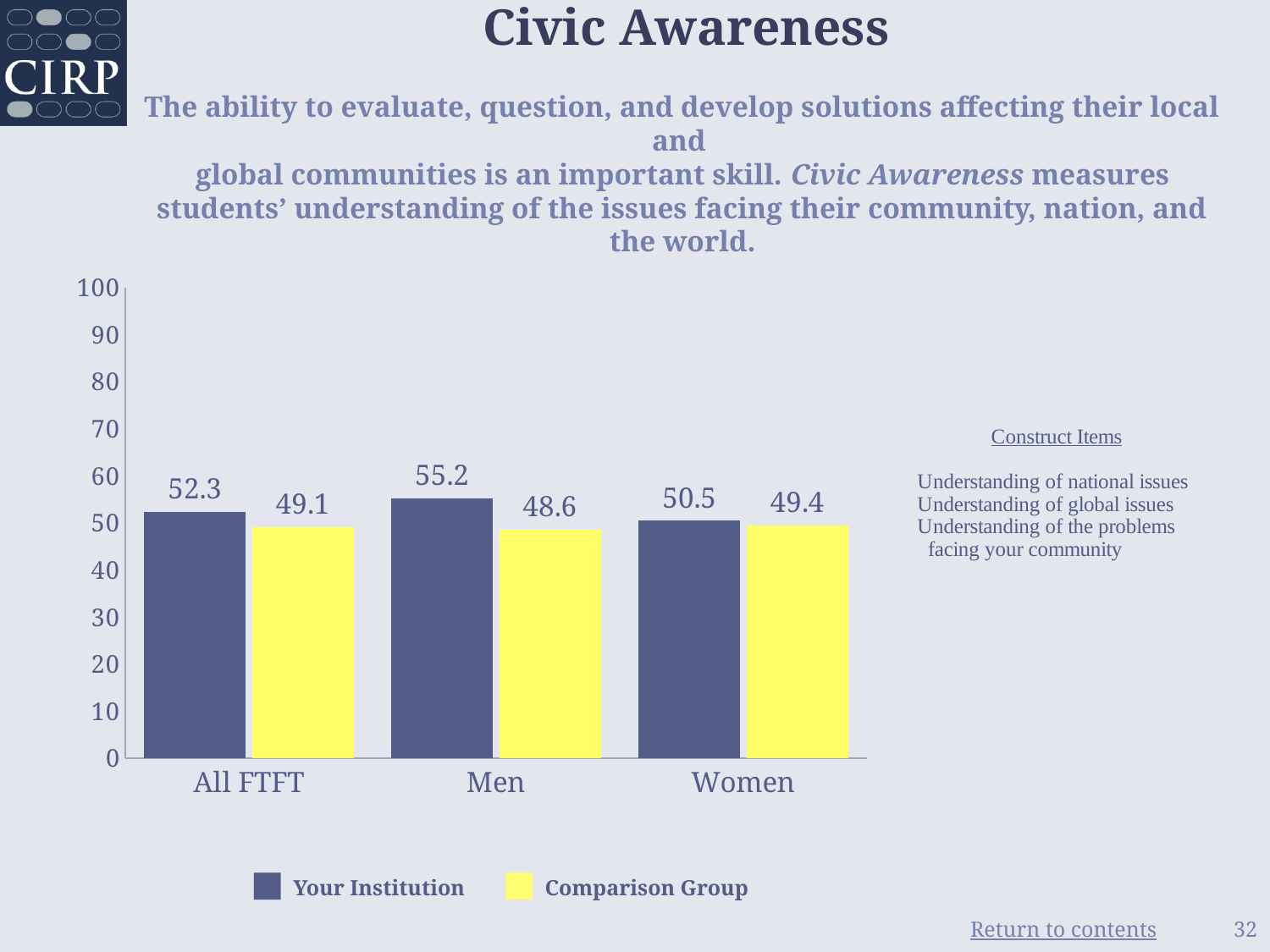
In the Women category, which is larger: Your Institution or Comparison Group? Your Institution Which category has the highest value for Your Institution? Men What is the difference between Your Institution and Comparison Group in the All FTFT category? 3.2 What is the value for Your Institution in the Women category? 50.5 How many series does the legend list? 2 What kind of chart is shown on the slide? bar chart Is the value for Comparison Group in the Men category greater or less than 50? less What is the value for Your Institution in the Men category? 55.2 What is the difference between Your Institution and Comparison Group in the Men category? 6.6 What is the value for Comparison Group in the All FTFT category? 49.1 How many categories are shown on the x axis? 3 Which category has the lowest value for Comparison Group? Men